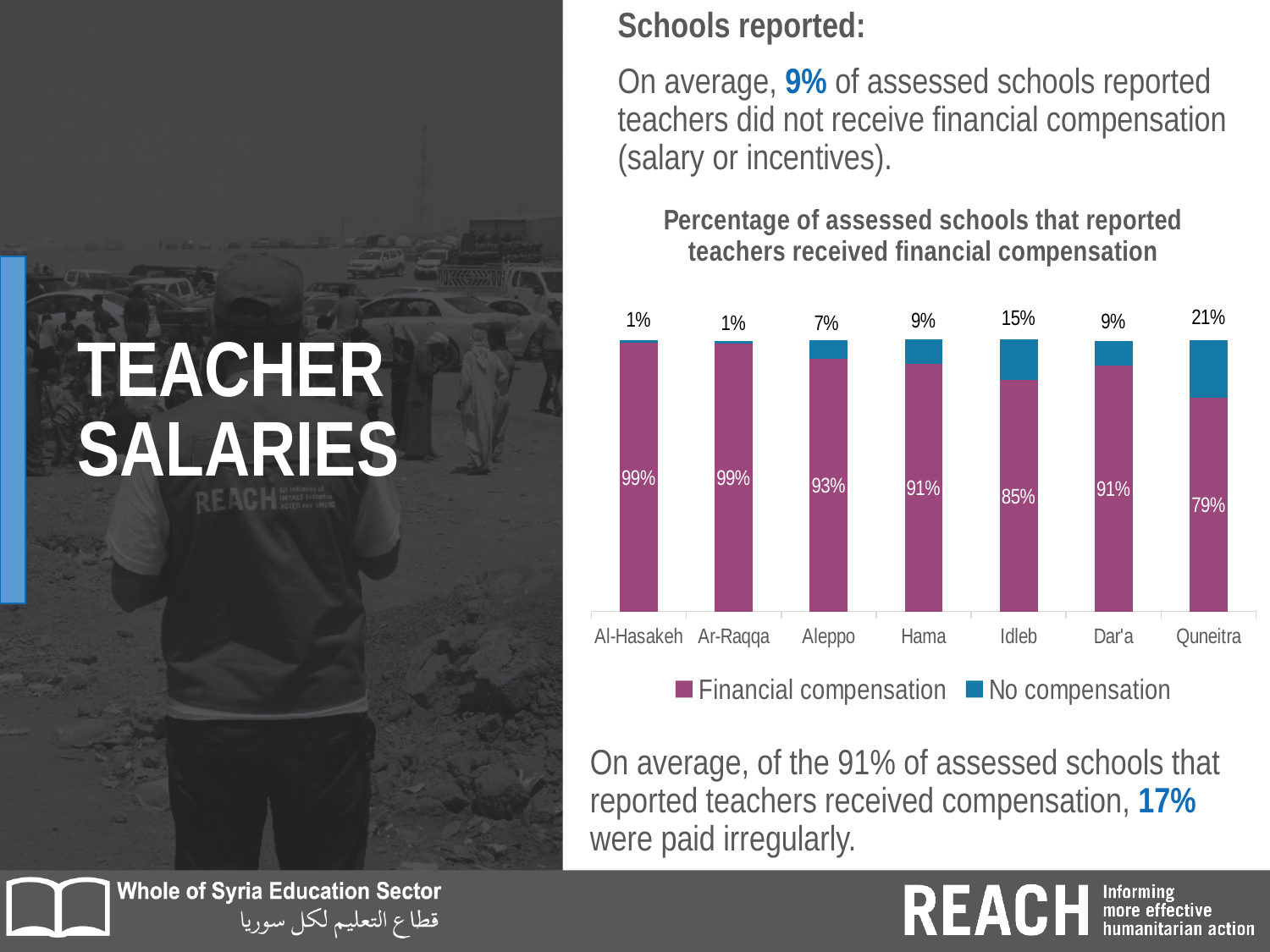
What is the 'No compensation' value for Quneitra? 21% What percentage of assessed schools in Idleb reported teachers received financial compensation? 85% How many series does the chart legend list? 2 What kind of chart is shown on the slide? Stacked bar chart How many governorates are shown on the x axis of the chart? 7 Which governorate has the lowest 'Financial compensation' value? Quneitra Which governorate has the highest 'No compensation' value? Quneitra What is the title of the chart? Percentage of assessed schools that reported teachers received financial compensation Which has a larger 'No compensation' value, Idleb or Hama? Idleb What is the 'Financial compensation' value for Aleppo? 93% What is the total of the stacked bar for Dar'a? 100% What is the difference between the 'Financial compensation' values for Al-Hasakeh and Quneitra? 20%